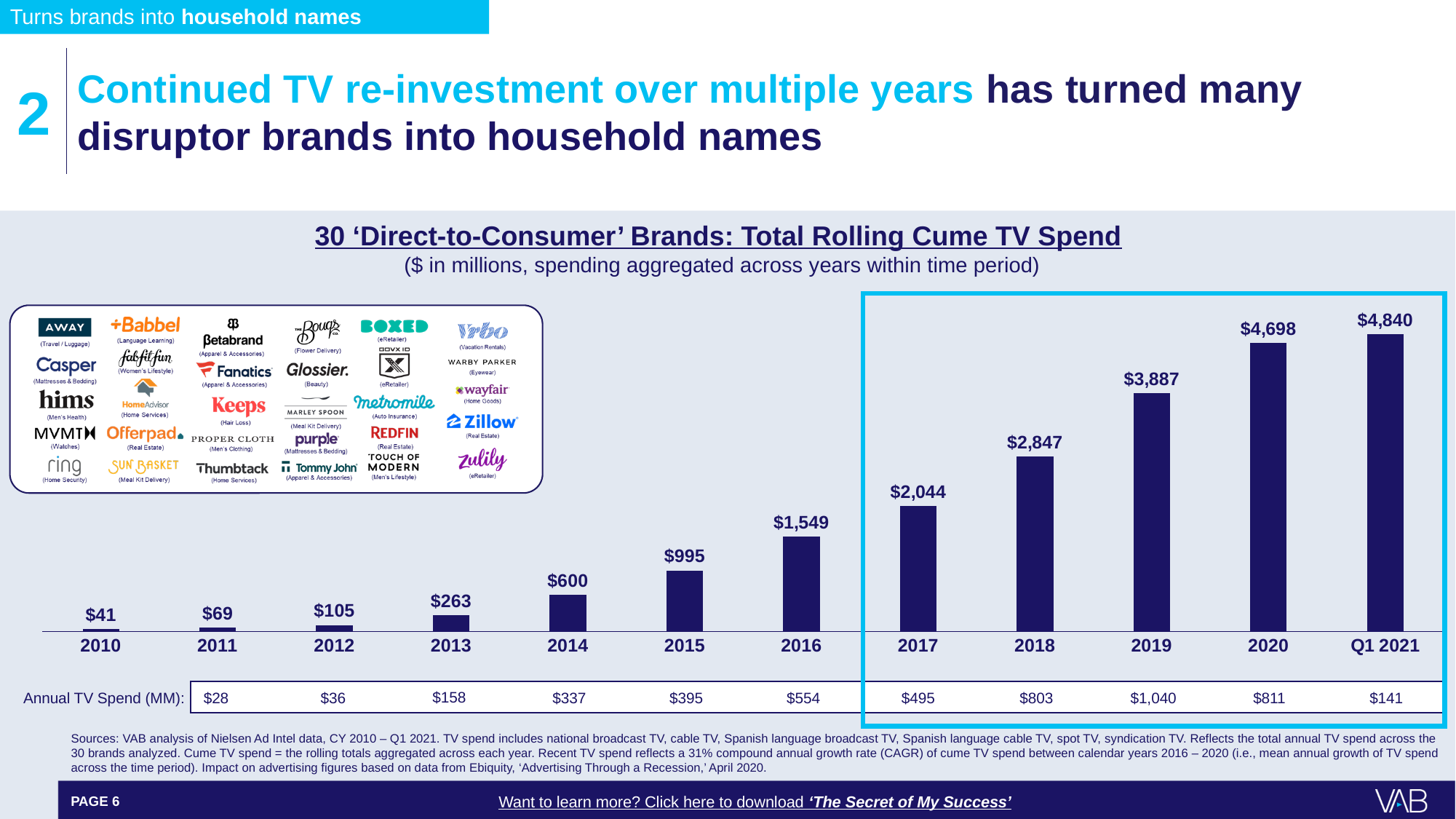
Do the cume TV spend values rise or fall from 2010 to Q1 2021? Rise How many periods (bars) are shown on the chart? 12 Which year has the lowest cume TV spend on the chart? 2010 What value is labeled on the bar for Q1 2021? $4,840 Which is larger, the cume TV spend for 2013 or for 2014? 2014 What kind of chart is used to show the cume TV spend? Bar chart What is the total rolling cume TV spend shown for 2016? $1,549 What is the Annual TV Spend (MM) listed below the chart for 2019? $1,040 What is the total rolling cume TV spend shown for 2019? $3,887 What is the difference between the cume TV spend for 2020 and 2019? $811 Which period has the highest cume TV spend on the chart? Q1 2021 What is the difference between the cume TV spend for 2016 and 2015? $554